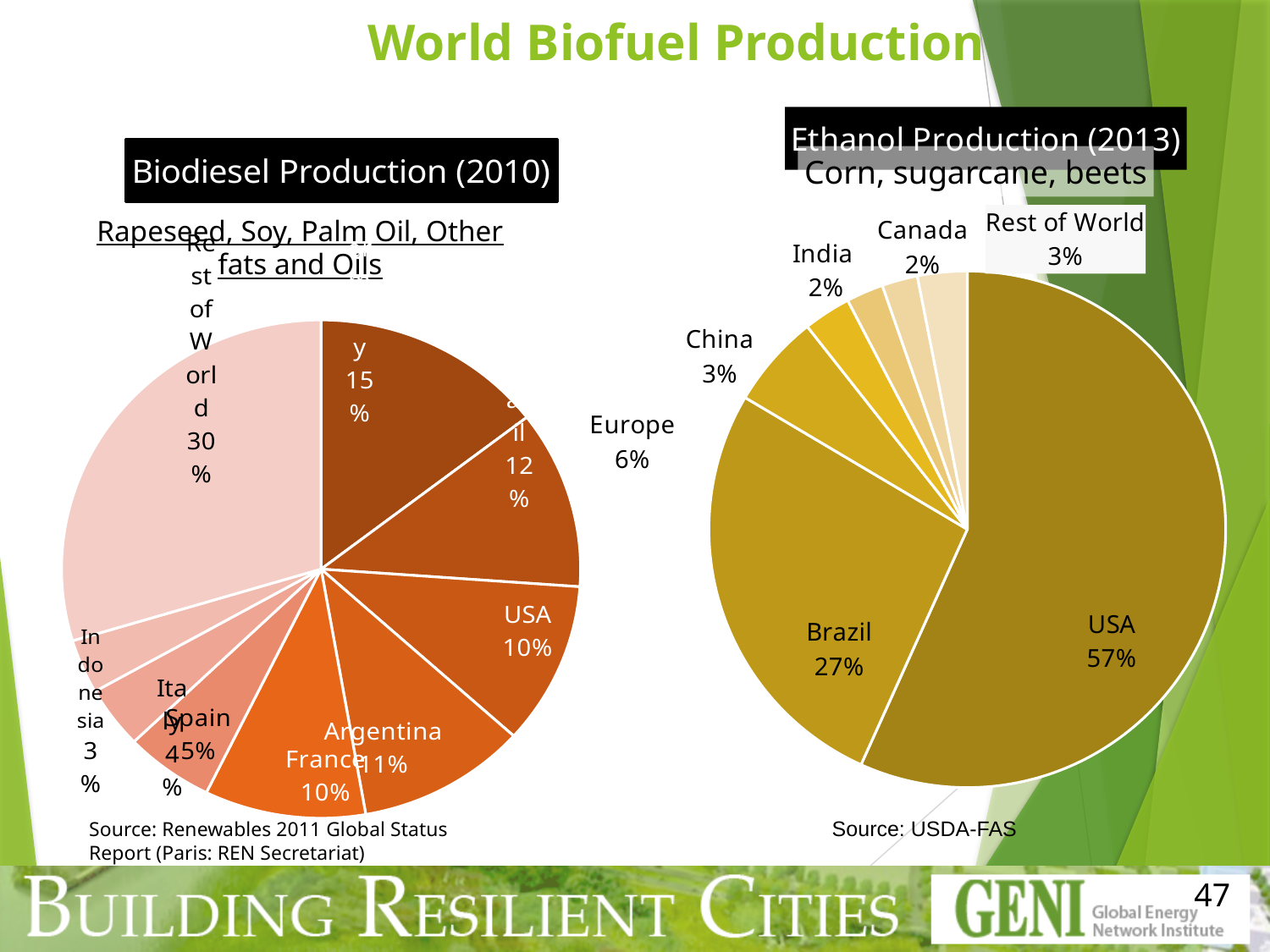
In the Ethanol Production (2013) chart, what is the difference between the USA share and the Brazil share? 30% In the Ethanol Production (2013) chart, how many slices does the pie have? 7 In the Ethanol Production (2013) chart, which country or region has the largest share? USA In the Ethanol Production (2013) chart, what share does Brazil have? 27% In the Ethanol Production (2013) chart, which is larger, China's share or Europe's share? Europe In the Ethanol Production (2013) chart, what share does Europe have? 6% In the Biodiesel Production (2010) chart, what share does Indonesia have? 3% In the Biodiesel Production (2010) chart, what share does Argentina have? 11% What type of chart is used for Ethanol Production (2013)? Pie chart In the Biodiesel Production (2010) chart, which is larger, the USA share or the Argentina share? Argentina In the Biodiesel Production (2010) chart, what share does Rest of World have? 30% In the Ethanol Production (2013) chart, what share does the USA have? 57%